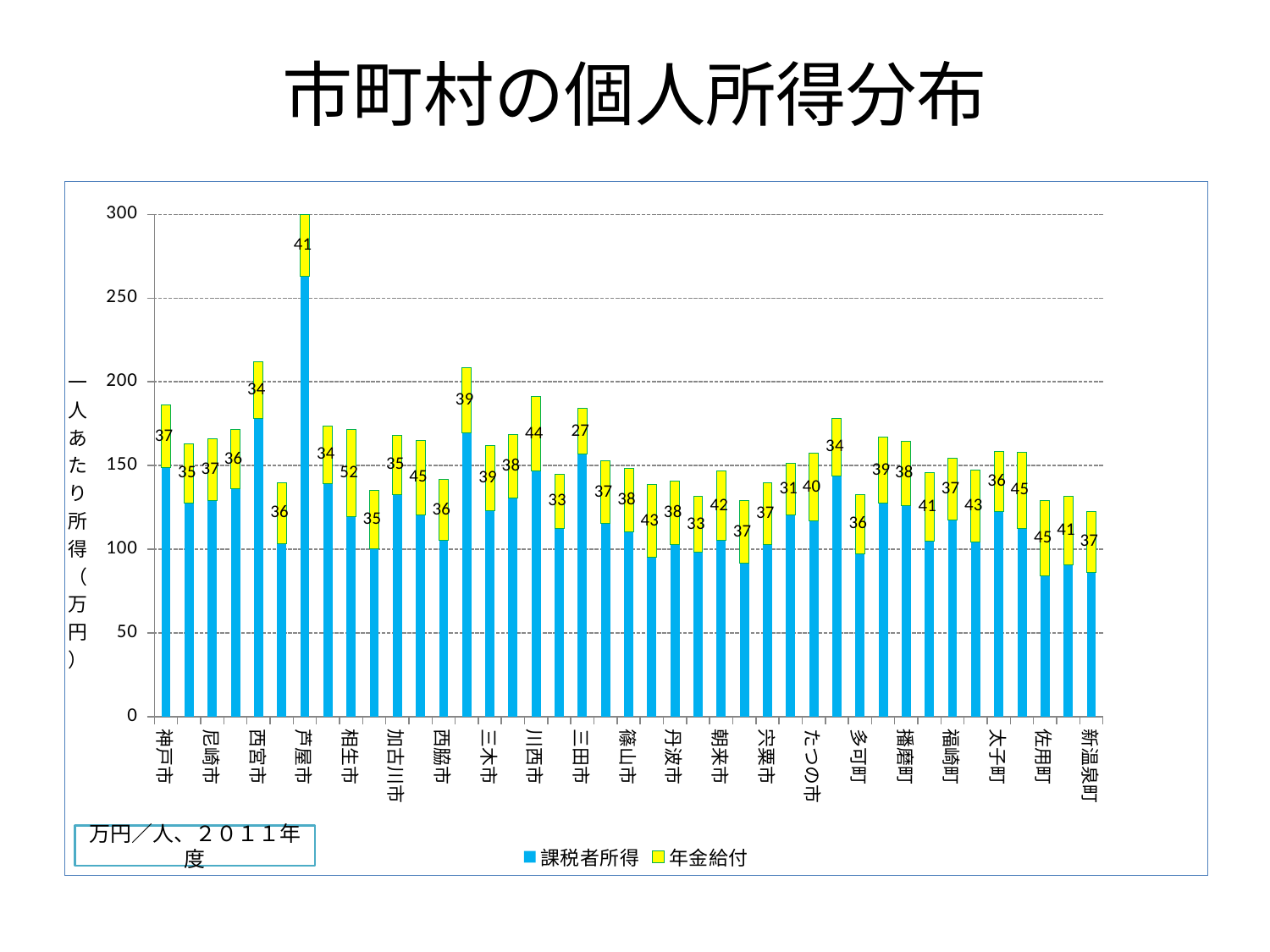
What is the 年金給付 value labelled for 三田市? 27 What are the two series named in the legend? 課税者所得 and 年金給付 Is the total bar height for 芦屋市 greater or less than 250? greater What is the difference between the 年金給付 values of 相生市 and 三田市? 25 What is the 年金給付 value labelled for 神戸市? 37 What is the 年金給付 value labelled for 芦屋市? 41 How many series does the legend list? 2 What is the 年金給付 value labelled for 相生市? 52 Which municipality has the lowest labelled 年金給付 value? 三田市 What kind of chart is shown on the slide? stacked bar chart Which municipality has the tallest stacked bar overall? 芦屋市 Which municipality has the highest labelled 年金給付 value? 相生市